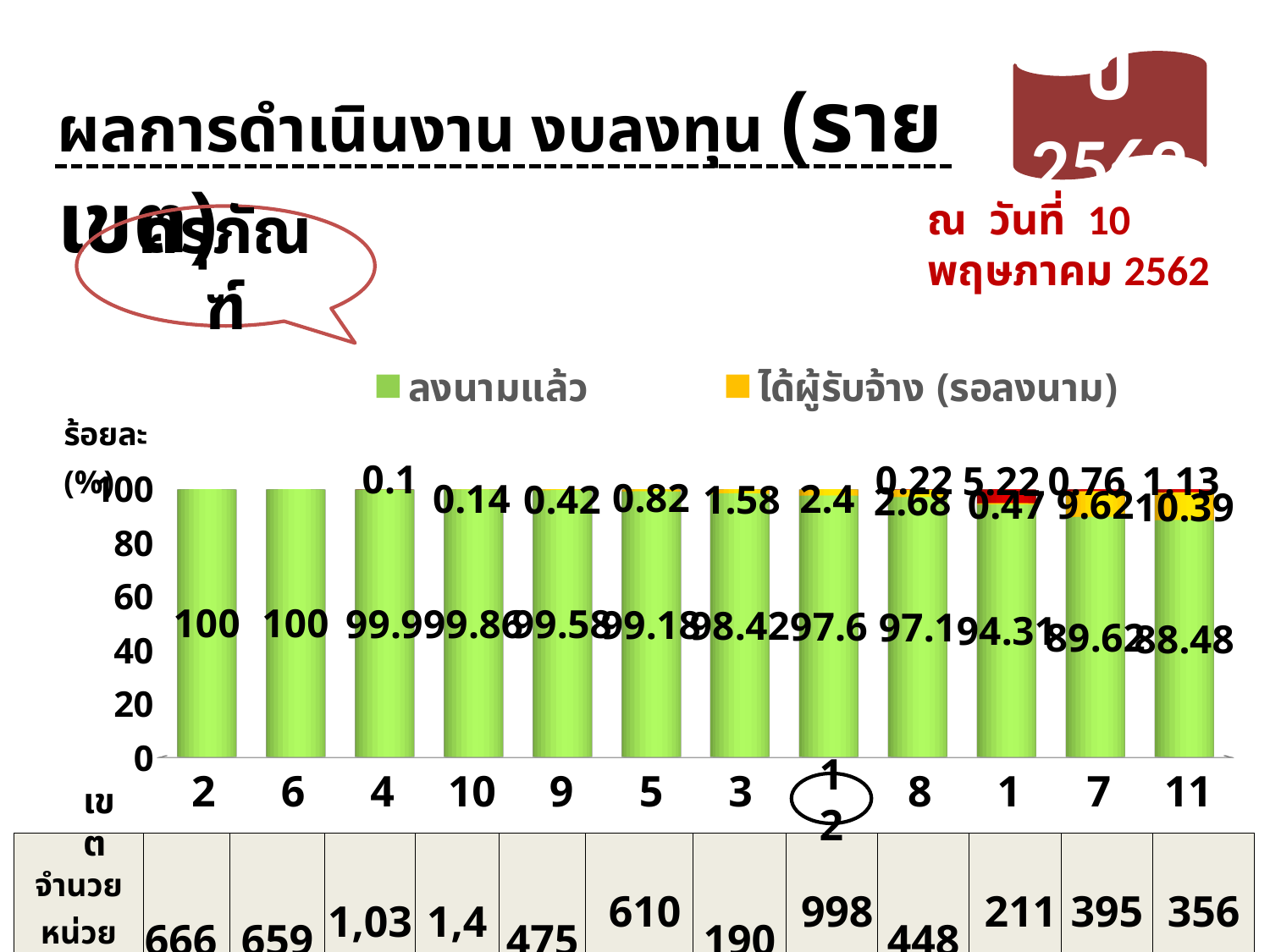
What is the ได้ผู้รับจ้าง (รอลงนาม) value for เขต 7? 9.62 How many เขต categories are shown on the x axis? 12 What is the ลงนามแล้ว value for เขต 11? 88.48 Do the ลงนามแล้ว values rise or fall from left to right along the x axis? Fall What is the ลงนามแล้ว value for เขต 2? 100 What kind of chart is shown? Bar chart What is the difference between the ลงนามแล้ว values for เขต 3 and เขต 12? 0.82 How many series does the legend list? 2 Which เขต has the highest ได้ผู้รับจ้าง (รอลงนาม) value? 11 Which เขต has the lowest ลงนามแล้ว value? 11 What is the ได้ผู้รับจ้าง (รอลงนาม) value for เขต 12? 2.4 Which has the larger ลงนามแล้ว value, เขต 1 or เขต 7? เขต 1